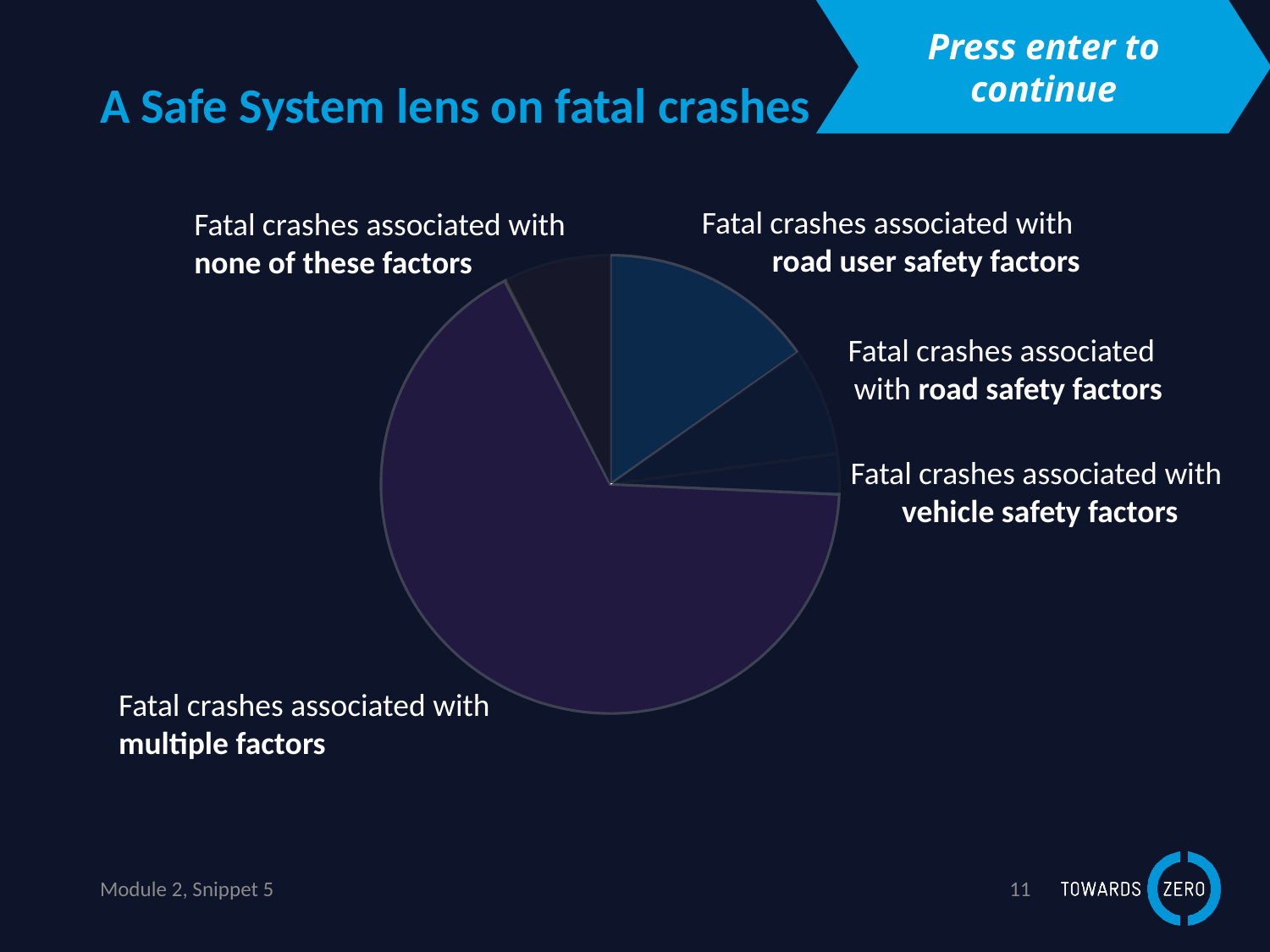
How many slices does the pie chart have? 5 What is the title of the slide containing the pie chart? A Safe System lens on fatal crashes Which category has the smallest slice of the pie chart? Fatal crashes associated with vehicle safety factors Which category has the largest slice of the pie chart? Fatal crashes associated with multiple factors Which slice is larger: fatal crashes associated with road safety factors or fatal crashes associated with vehicle safety factors? road safety factors Which slice is larger: fatal crashes associated with road user safety factors or fatal crashes associated with none of these factors? road user safety factors Which category label is placed below the pie chart, at the bottom left? Fatal crashes associated with multiple factors What kind of chart is shown on the slide? pie chart Does the slice for fatal crashes associated with multiple factors make up more or less than half of the pie? more Which slice is larger: fatal crashes associated with multiple factors or fatal crashes associated with road user safety factors? multiple factors